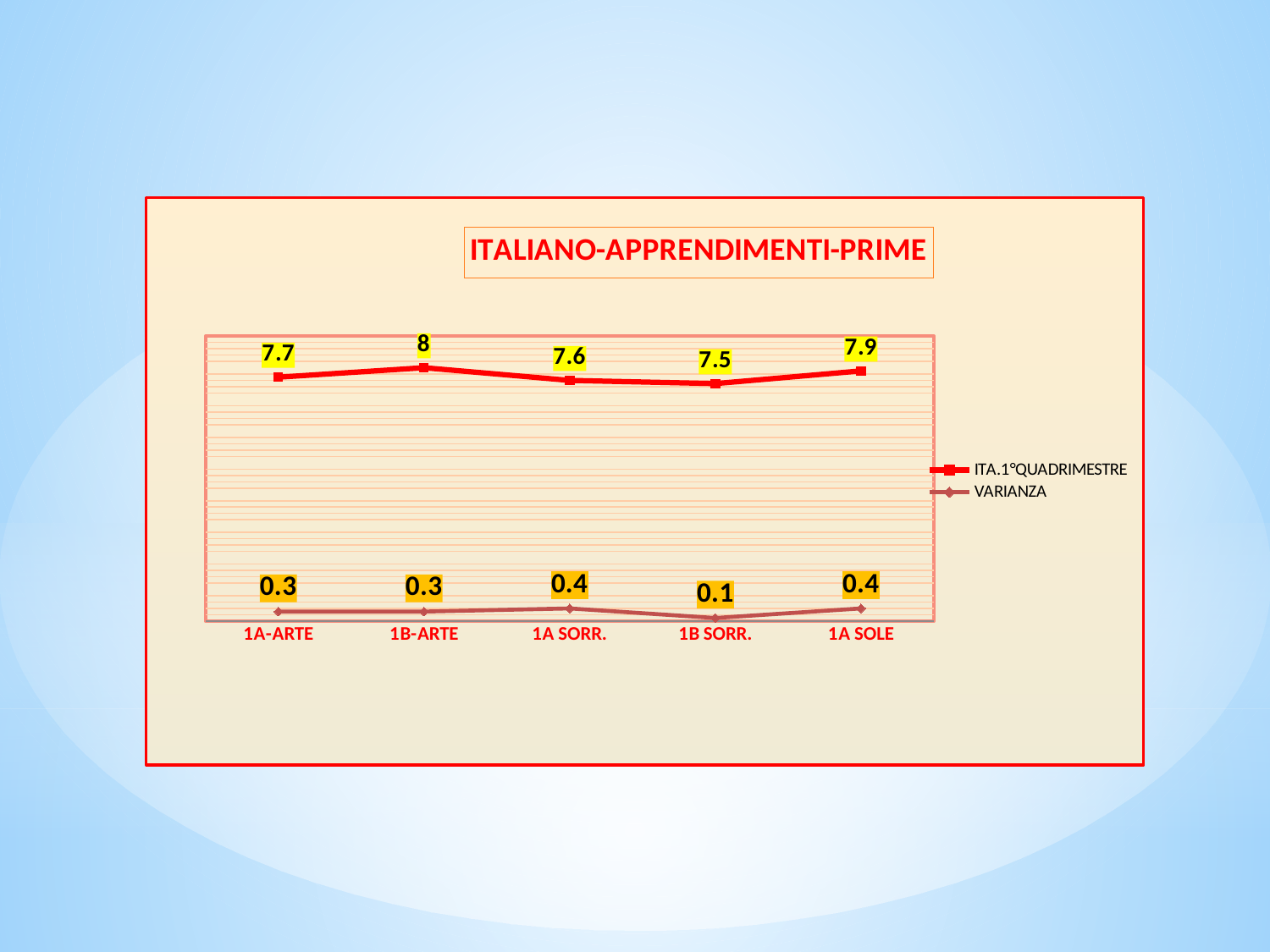
Which category has the lowest VARIANZA value? 1B SORR. What kind of chart is shown on the slide? Line chart What is the ITA.1°QUADRIMESTRE value for 1B-ARTE? 8 What is the title of the chart? ITALIANO-APPRENDIMENTI-PRIME Which category has the lowest ITA.1°QUADRIMESTRE value? 1B SORR. What is the ITA.1°QUADRIMESTRE value for 1A SOLE? 7.9 How many series does the legend list? 2 What is the difference between the ITA.1°QUADRIMESTRE values for 1B-ARTE and 1B SORR.? 0.5 How many categories are shown on the x axis? 5 Which is larger, the ITA.1°QUADRIMESTRE value for 1A-ARTE or for 1A SORR.? 1A-ARTE Which category has the highest ITA.1°QUADRIMESTRE value? 1B-ARTE What is the VARIANZA value for 1B SORR.? 0.1